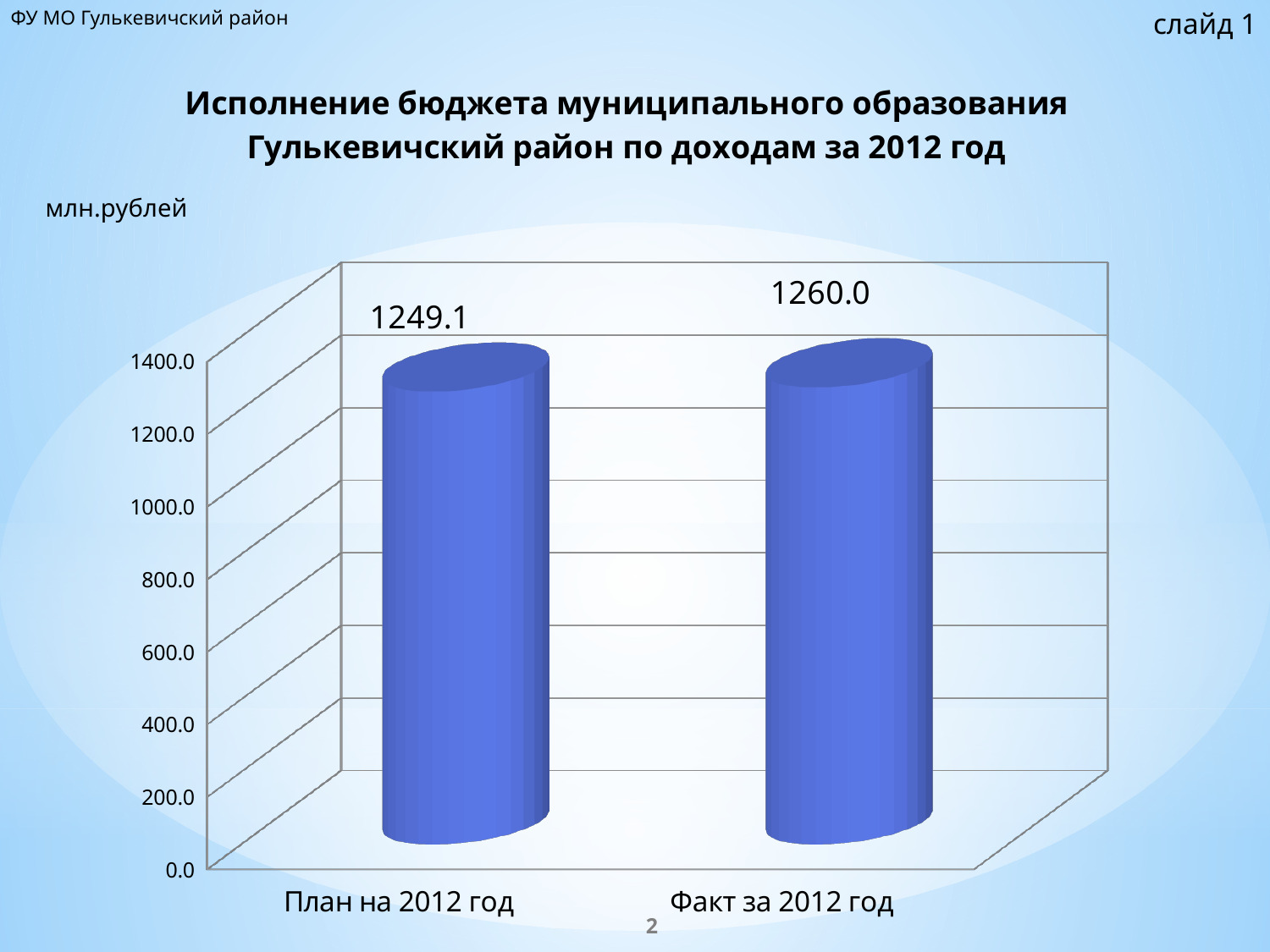
What is the value for Факт за 2012 год? 1260.0 Which category has the lowest value? План на 2012 год What kind of chart is shown on the slide? bar chart What is the title of the chart? Исполнение бюджета муниципального образования Гулькевичский район по доходам за 2012 год How many categories are shown on the chart? 2 Is the value for Факт за 2012 год greater or less than 1400.0? less What is the value for План на 2012 год? 1249.1 Which is larger: the value for План на 2012 год or the value for Факт за 2012 год? Факт за 2012 год Which category has the highest value? Факт за 2012 год What is the difference between the value for Факт за 2012 год and the value for План на 2012 год? 10.9 What unit of measurement is indicated above the chart? млн.рублей Is the value for План на 2012 год greater or less than 1200.0? greater